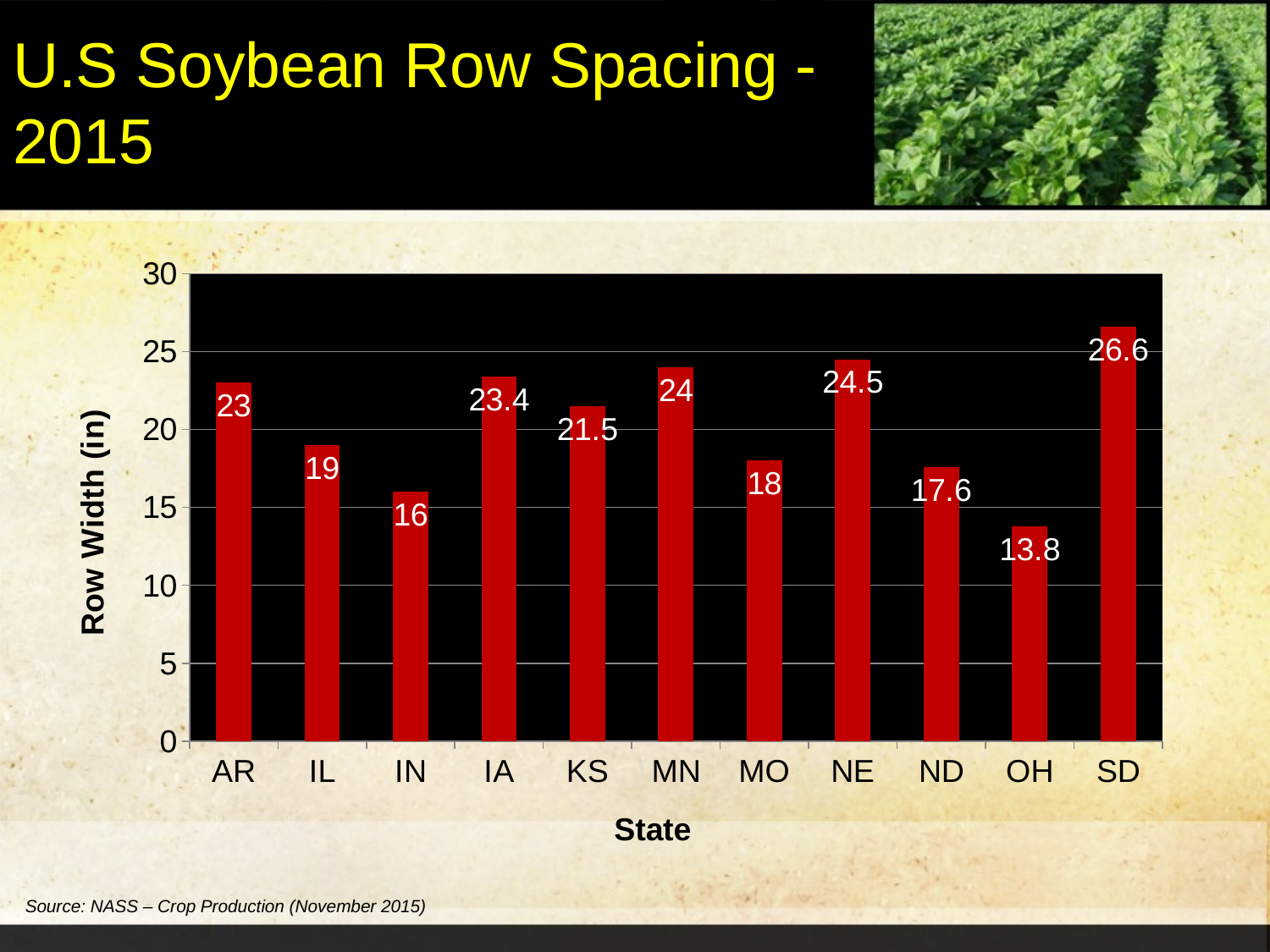
Which state has the highest row width? SD Which state has the lowest row width? OH What is the row width for IA? 23.4 What is the label of the y axis? Row Width (in) What is the row width for NE? 24.5 What is the difference in row width between SD and OH? 12.8 Is the row width for KS greater or less than 20? greater Which has a larger row width, MN or MO? MN What is the row width for OH? 13.8 What kind of chart is shown on the slide? bar chart What is the difference in row width between AR and IL? 4 How many states are shown on the chart? 11